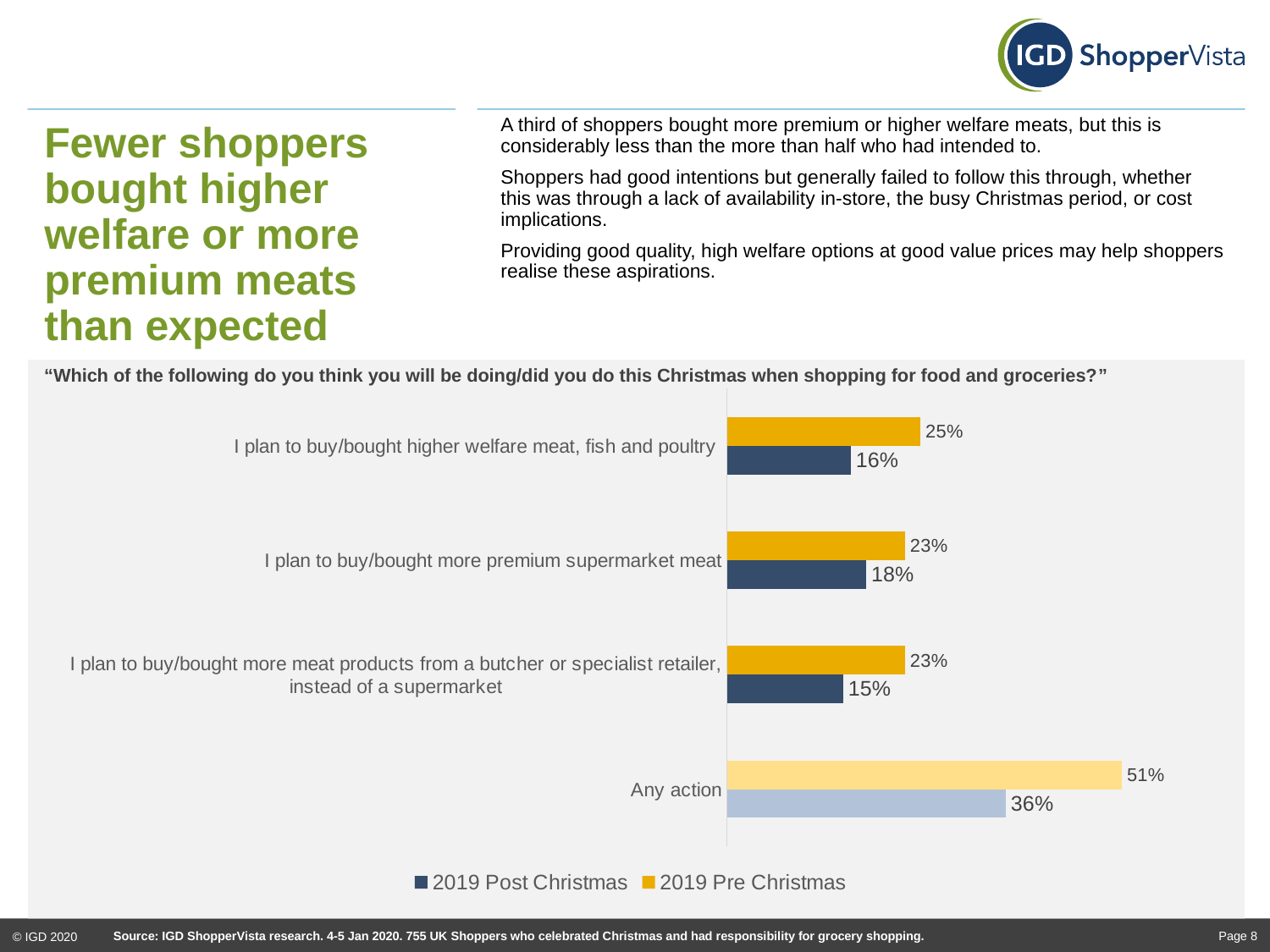
What is the 2019 Pre Christmas value for "I plan to buy/bought higher welfare meat, fish and poultry"? 25% Which category has the lowest 2019 Post Christmas value? I plan to buy/bought more meat products from a butcher or specialist retailer, instead of a supermarket How many series does the legend list? 2 What is the 2019 Post Christmas value for "Any action"? 36% What is the 2019 Post Christmas value for "I plan to buy/bought more premium supermarket meat"? 18% For "I plan to buy/bought more premium supermarket meat", which is larger: the 2019 Pre Christmas value or the 2019 Post Christmas value? 2019 Pre Christmas What is the difference between the 2019 Pre Christmas and 2019 Post Christmas values for "I plan to buy/bought higher welfare meat, fish and poultry"? 9% Which category has the highest 2019 Pre Christmas value? Any action What kind of chart is shown on the slide? Bar chart What is the 2019 Pre Christmas value for "I plan to buy/bought more meat products from a butcher or specialist retailer, instead of a supermarket"? 23% How many categories are shown on the chart? 4 What is the difference between the 2019 Pre Christmas and 2019 Post Christmas values for "Any action"? 15%